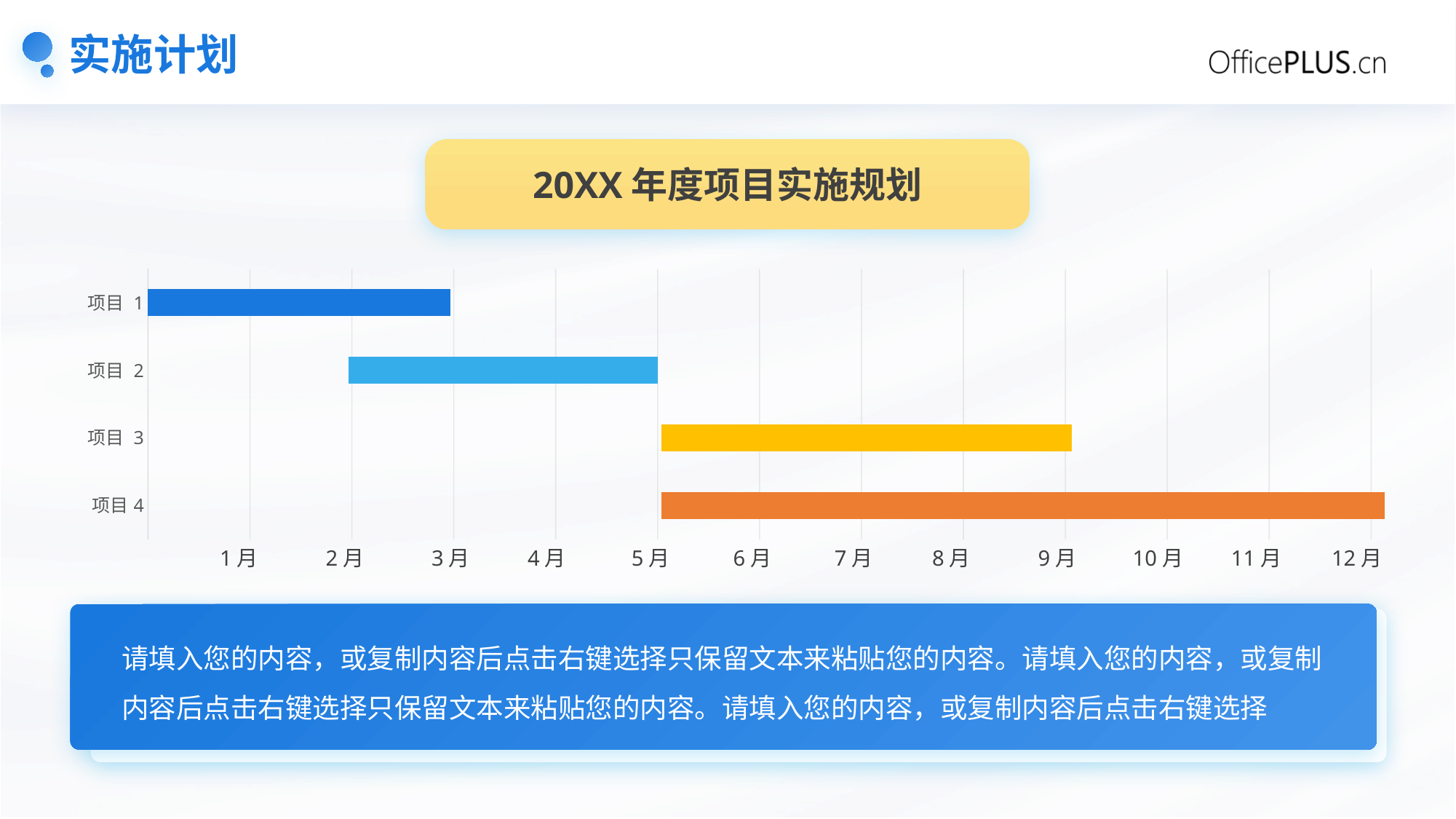
Which bar is longer, 项目 3 or 项目 4? 项目 4 What kind of chart is shown on the slide? Bar chart Which project's bar extends furthest to the right (ends latest)? 项目 4 Which project has the longest bar on the chart? 项目 4 Does the bar for 项目 2 start before or after the 3月 tick? before Which bar is longer, 项目 1 or 项目 4? 项目 4 Which project's bar starts earliest on the x axis? 项目 1 Does the bar for 项目 3 end before or after the 8月 tick? after How many month labels are shown along the x axis? 12 What is the title shown above the chart? 20XX 年度项目实施规划 What colour is the bar for 项目 4? Orange How many projects (categories) are plotted on the chart? 4